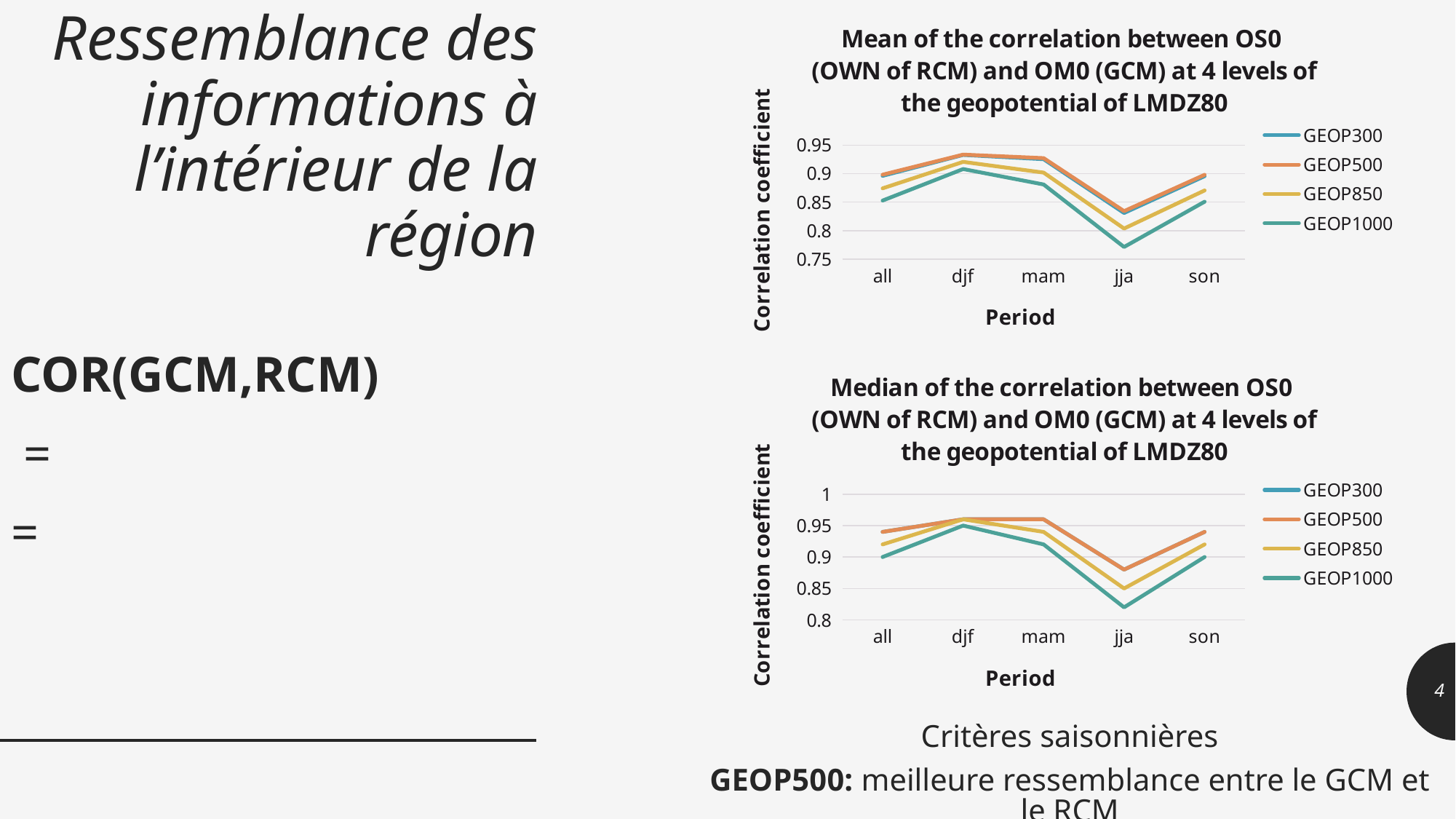
In the top chart ('Mean of the correlation...'), is the value for GEOP1000 at jja greater or less than 0.8? less In the bottom chart ('Median of the correlation...'), is the value for GEOP1000 at jja greater or less than 0.85? less In the bottom chart ('Median of the correlation...'), which period has the lowest value for GEOP850? jja In the top chart ('Mean of the correlation...'), which is larger for GEOP500: the value at djf or the value at jja? djf In the bottom chart ('Median of the correlation...'), is the value for GEOP500 at jja greater or less than 0.85? greater How many series does the legend of the bottom chart ('Median of the correlation...') list? 4 How many periods are shown on the x axis of the top chart ('Mean of the correlation...')? 5 In the bottom chart ('Median of the correlation...'), do the values for GEOP1000 rise or fall from mam to jja? fall What is the label of the x axis of the top chart ('Mean of the correlation...')? Period In the top chart ('Mean of the correlation...'), which period has the lowest value for GEOP1000? jja What kind of chart is the top chart, 'Mean of the correlation between OS0 (OWN of RCM) and OM0 (GCM) at 4 levels of the geopotential of LMDZ80'? line chart